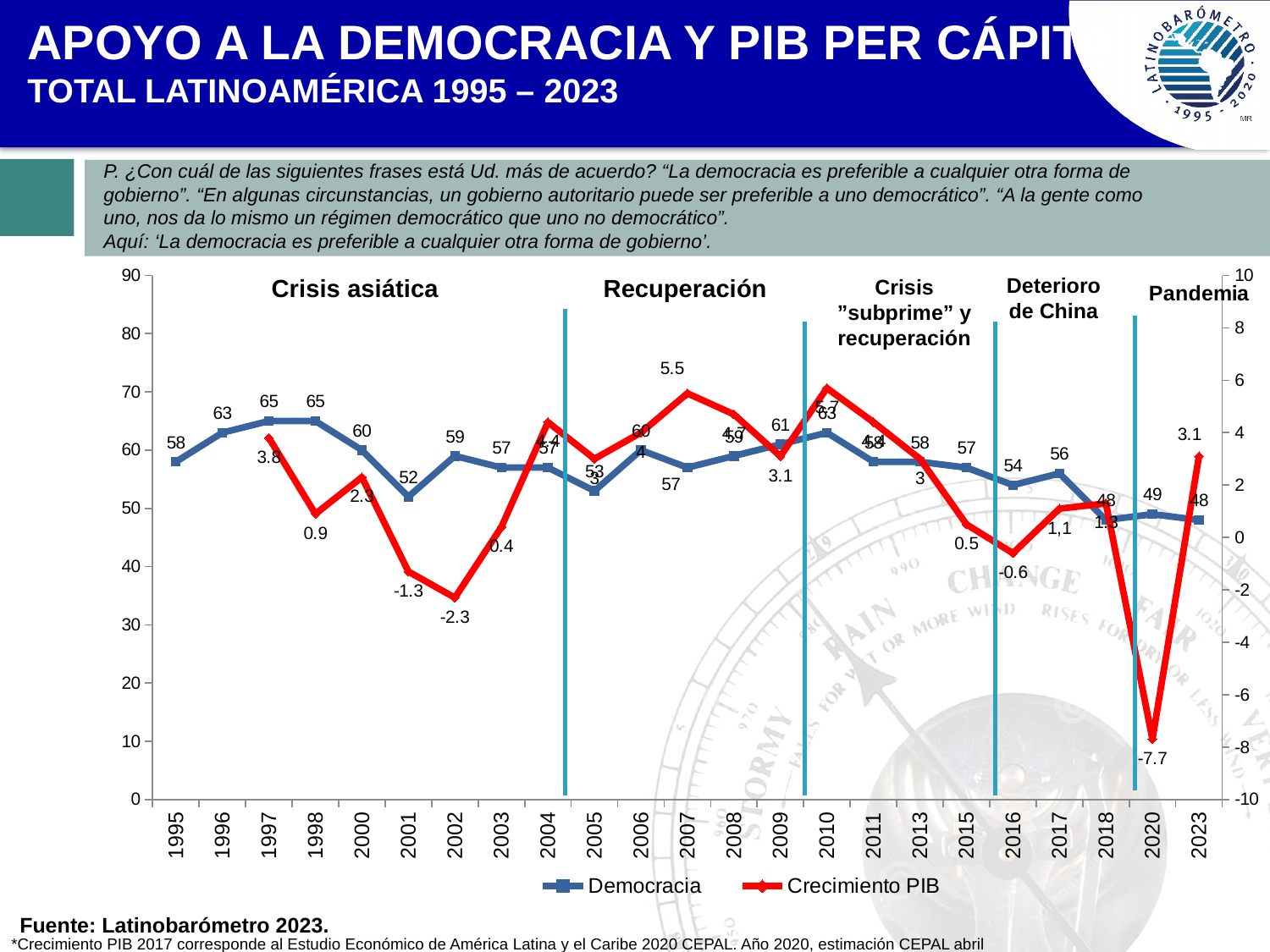
What is the Democracia value for 2001? 52 What is the difference between the Democracia value in 1995 and in 2023? 10 What kind of chart is shown on the slide? line chart In which year is the Crecimiento PIB value lowest? 2020 What is the Crecimiento PIB value for 2002? -2.3 What is the Crecimiento PIB value for 2020? -7.7 Which is larger, the Democracia value for 2001 or for 2002? 2002 How many years are shown on the x axis? 23 What is the Crecimiento PIB value for 2007? 5.5 Does the Democracia series rise or fall from 1995 to 1998? rise How many series does the legend list? 2 What is the Democracia value for 1995? 58